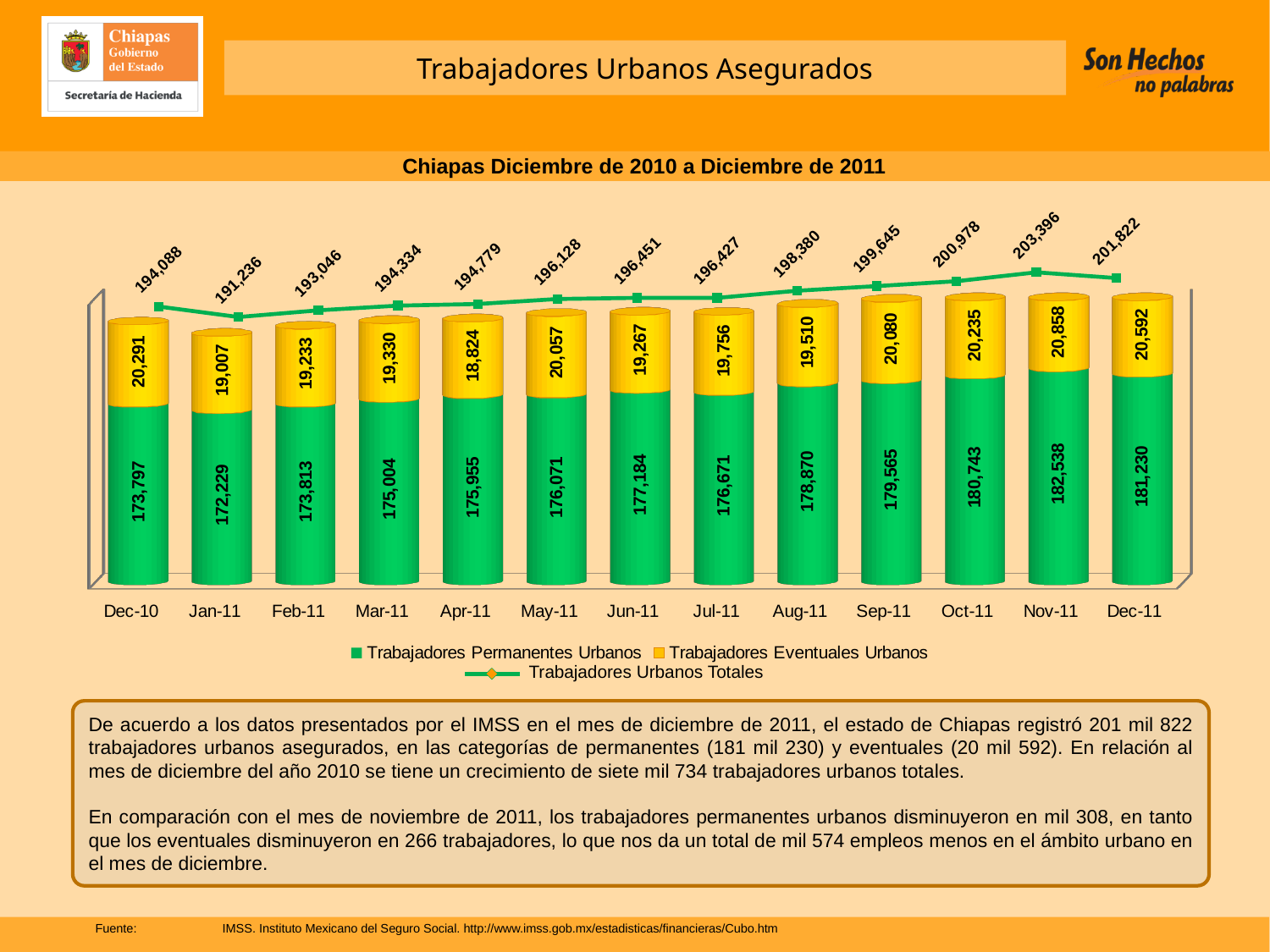
How many series does the legend list? 3 What is the value of Trabajadores Permanentes Urbanos for Dec-11? 181,230 What is the total of the stacked bar for Dec-11 (permanentes plus eventuales)? 201,822 How many months are shown on the x axis? 13 What is the difference between Trabajadores Urbanos Totales in Dec-11 and Dec-10? 7,734 By how much did Trabajadores Permanentes Urbanos fall from Nov-11 to Dec-11? 1,308 What is the value of Trabajadores Eventuales Urbanos for Apr-11? 18,824 In which month is Trabajadores Urbanos Totales highest? Nov-11 Which is larger, Trabajadores Eventuales Urbanos in Dec-10 or in Jan-11? Dec-10 In which month is Trabajadores Eventuales Urbanos lowest? Apr-11 In which month is Trabajadores Permanentes Urbanos lowest? Jan-11 What is the value of Trabajadores Urbanos Totales for Aug-11? 198,380